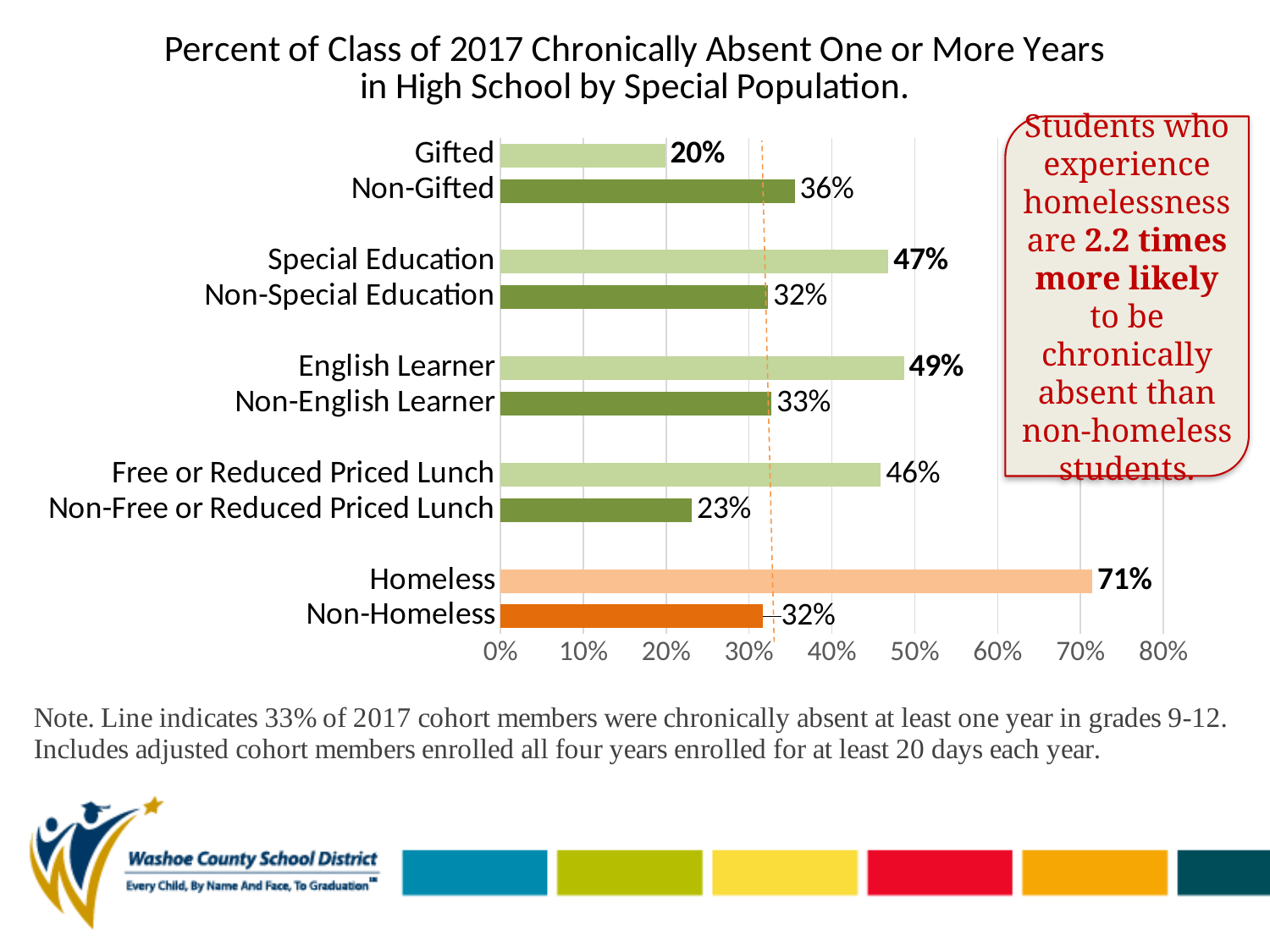
What kind of chart is shown on the slide? Bar chart What is the difference between the values for Homeless and Non-Homeless? 39% Which category has the highest value? Homeless What is the difference between the values for Special Education and Non-Special Education? 15% Which category has the lowest value? Gifted What is the value for English Learner? 49% How many categories are shown in the chart? 10 Which is larger, the value for Non-Gifted or the value for Non-English Learner? Non-Gifted What is the value for Gifted? 20% What is the value for Non-Free or Reduced Priced Lunch? 23% What is the title of the chart? Percent of Class of 2017 Chronically Absent One or More Years in High School by Special Population. What is the value for Homeless? 71%